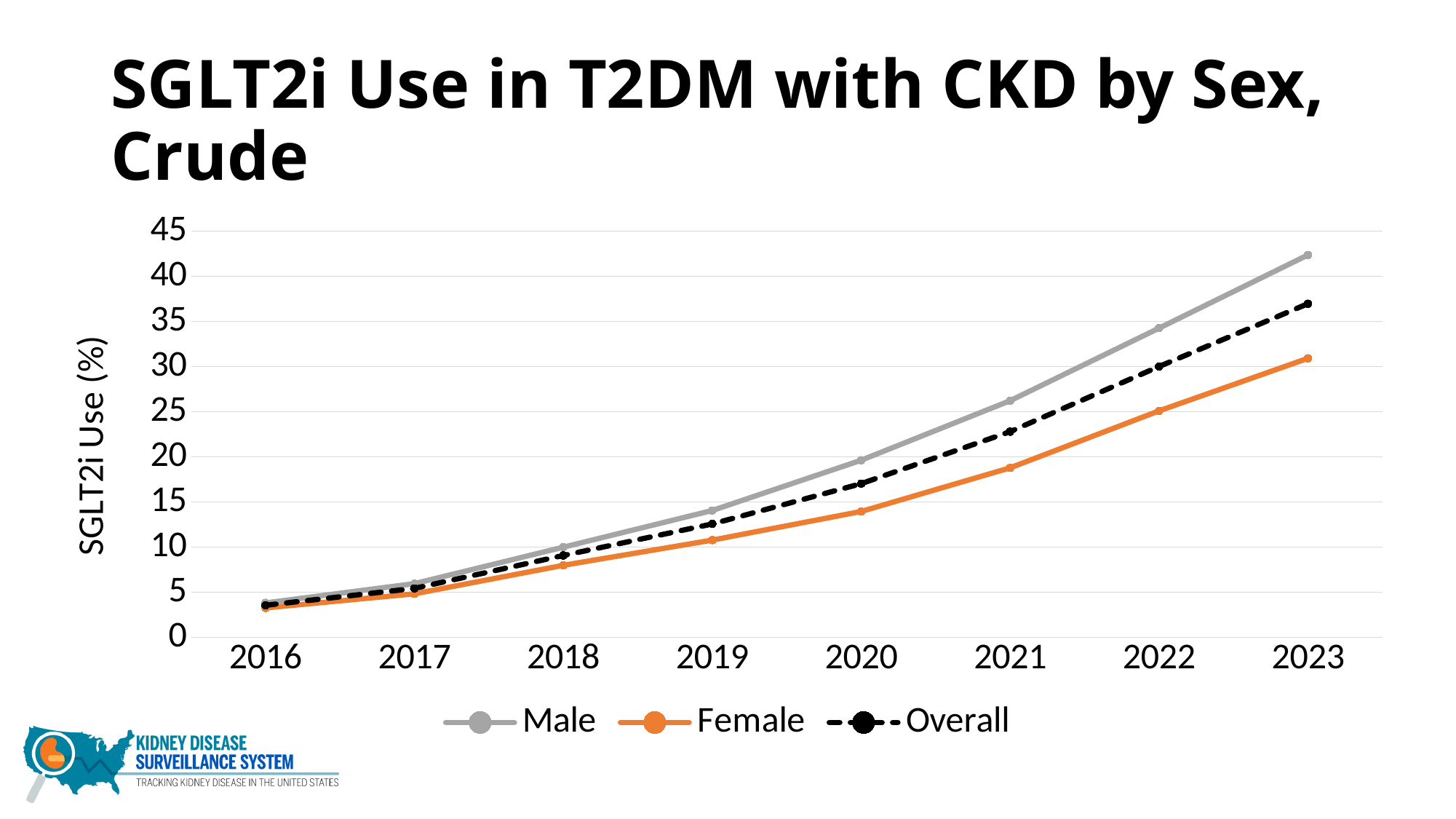
What is the label on the y axis? SGLT2i Use (%) Is the Male value in 2021 greater or less than 25? greater Is the Female value in 2023 greater or less than 35? less Is the Overall value in 2020 greater or less than 20? less Do the values for the Overall series rise or fall from 2016 to 2023? rise Which series has the lowest value in 2023? Female Which series has the highest value in 2023? Male How many series does the legend list? 3 Which is larger in 2022, the Male value or the Female value? Male What kind of chart is shown on the slide? line chart How many years are plotted along the x axis? 8